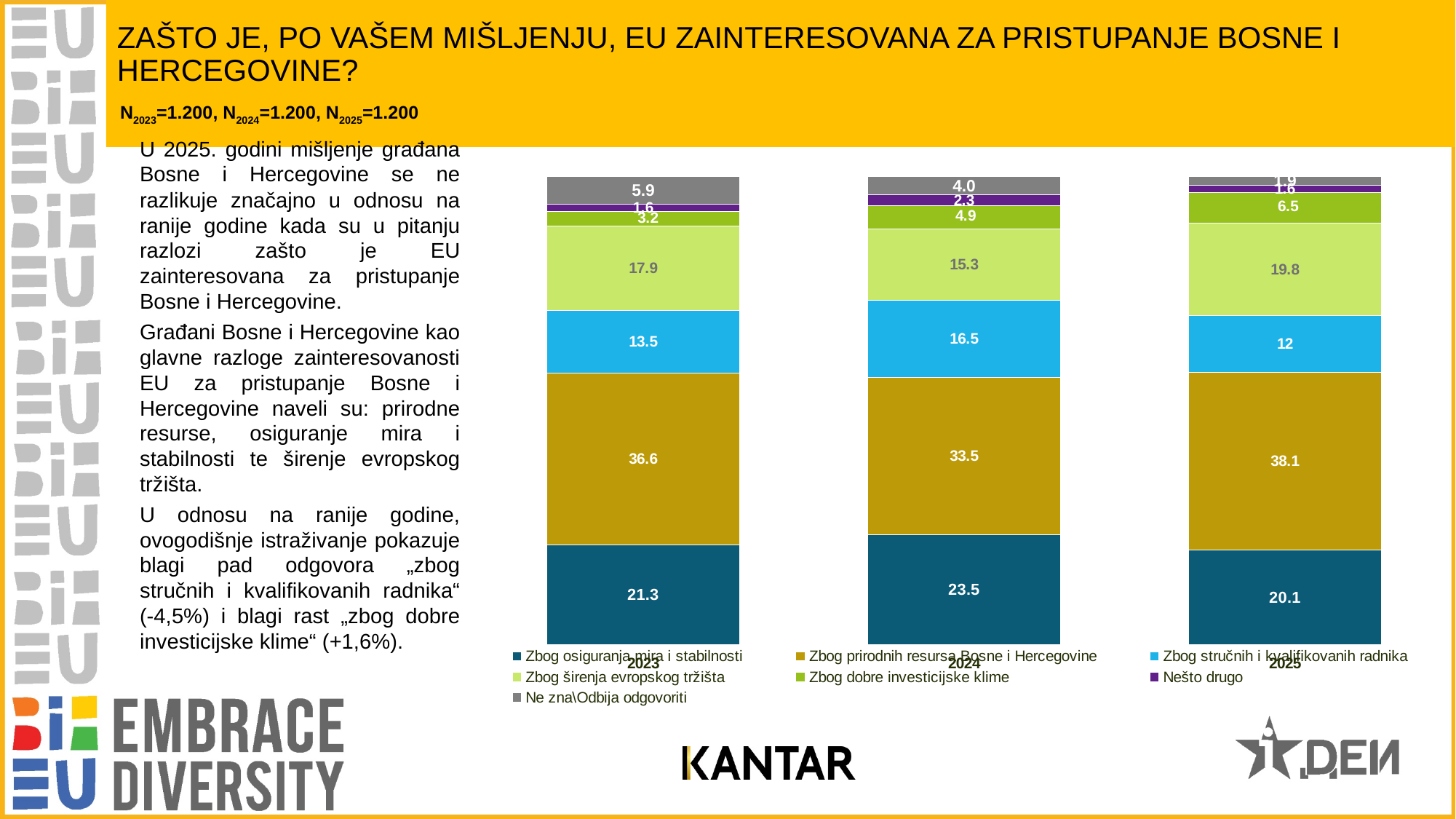
What is the value for "Zbog osiguranja mira i stabilnosti" in 2024? 23.5 How many years (bars) are shown on the x axis? 3 What kind of chart is shown on the slide? stacked bar chart What is the value for "Zbog stručnih i kvalifikovanih radnika" in 2023? 13.5 What is the value for "Zbog širenja evropskog tržišta" in 2025? 19.8 In which year is the value for "Zbog prirodnih resursa Bosne i Hercegovine" the highest? 2025 How many series does the legend list? 7 What is the value for "Zbog prirodnih resursa Bosne i Hercegovine" in 2025? 38.1 What is the value for "Ne zna\Odbija odgovoriti" in 2023? 5.9 What is the difference between the 2024 and 2023 values for "Zbog stručnih i kvalifikovanih radnika"? 3.0 In which year is the value for "Zbog stručnih i kvalifikovanih radnika" the lowest? 2025 Which is larger: the 2023 value for "Zbog širenja evropskog tržišta" or the 2024 value for the same series? 2023